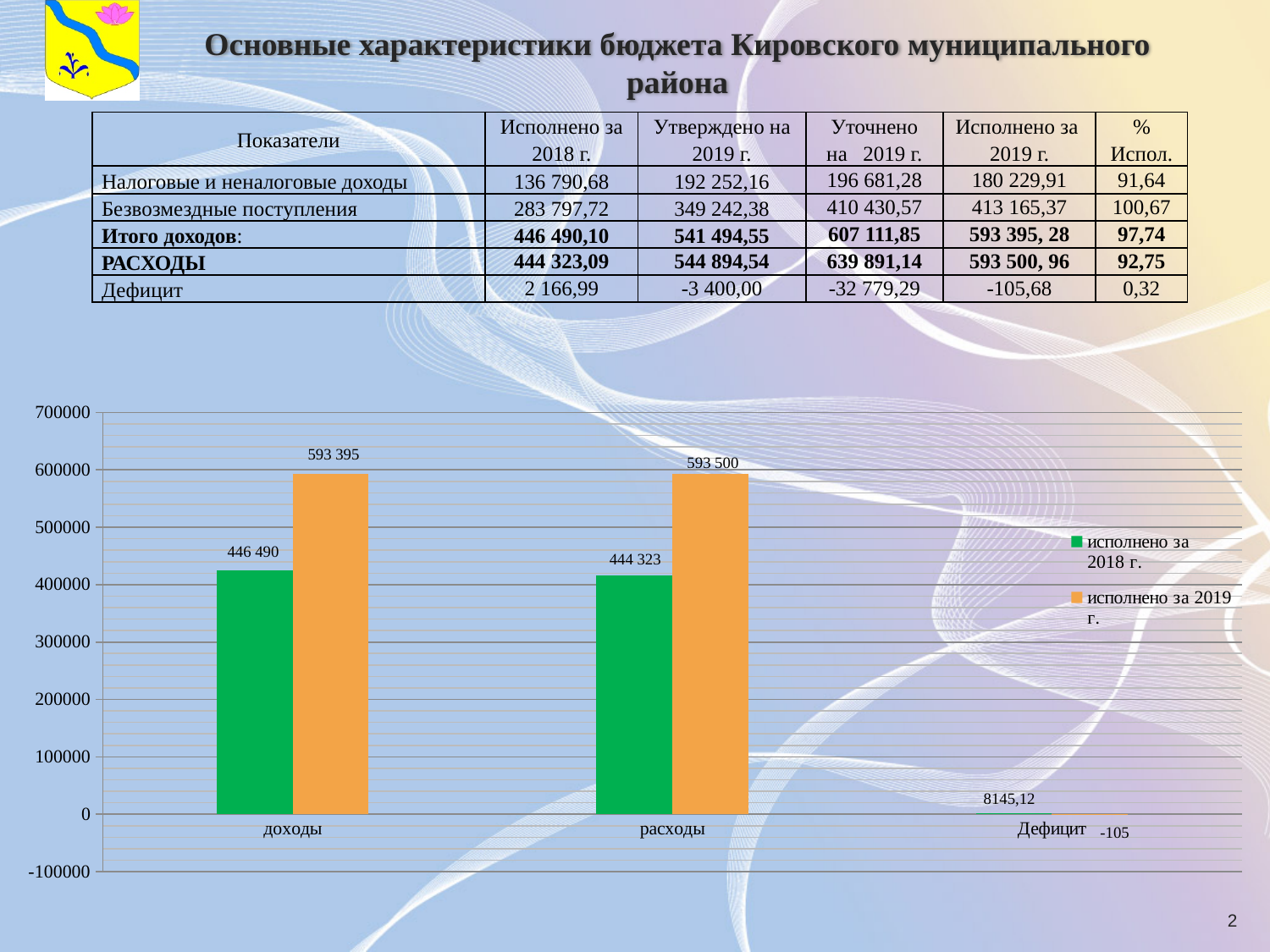
What is the value for Дефицит in the series исполнено за 2019 г.? -105 Which category has the lowest values in the chart? Дефицит What is the value for доходы in the series исполнено за 2019 г.? 593 395 For доходы, which series has the larger value: исполнено за 2018 г. or исполнено за 2019 г.? исполнено за 2019 г. How many categories are shown on the x axis of the chart? 3 How many series does the chart legend list? 2 What is the value for доходы in the series исполнено за 2018 г.? 446 490 What is the difference between the 2019 and 2018 values for доходы? 146 905 What kind of chart is shown on the slide? bar chart What is the difference between the 2019 and 2018 values for расходы? 149 177 What is the value for расходы in the series исполнено за 2018 г.? 444 323 What is the value for расходы in the series исполнено за 2019 г.? 593 500